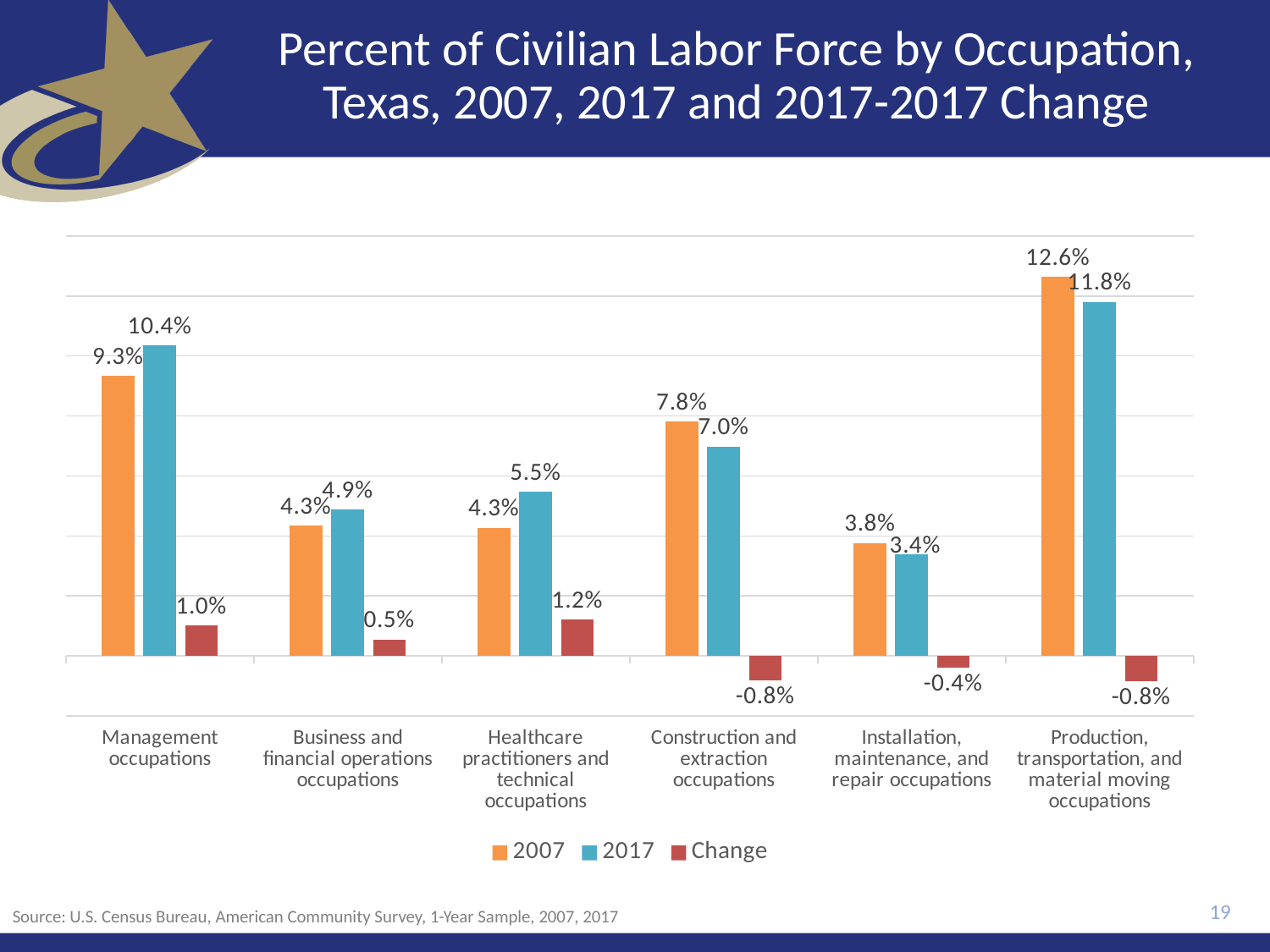
What kind of chart is shown on the slide? Bar chart What is the Change value for Construction and extraction occupations? -0.8% Which occupation has the lowest 2007 value? Installation, maintenance, and repair occupations Which occupation has the highest 2017 value? Production, transportation, and material moving occupations How many series does the legend list? 3 How many occupation categories are shown on the chart? 6 What was the 2007 value for Management occupations? 9.3% Which is larger for Construction and extraction occupations, the 2007 value or the 2017 value? 2007 Which occupation has the largest positive Change value? Healthcare practitioners and technical occupations What colour represents the 2017 series in the legend? Blue What is the difference between the 2017 and 2007 values for Management occupations? 1.1% What was the 2017 value for Healthcare practitioners and technical occupations? 5.5%